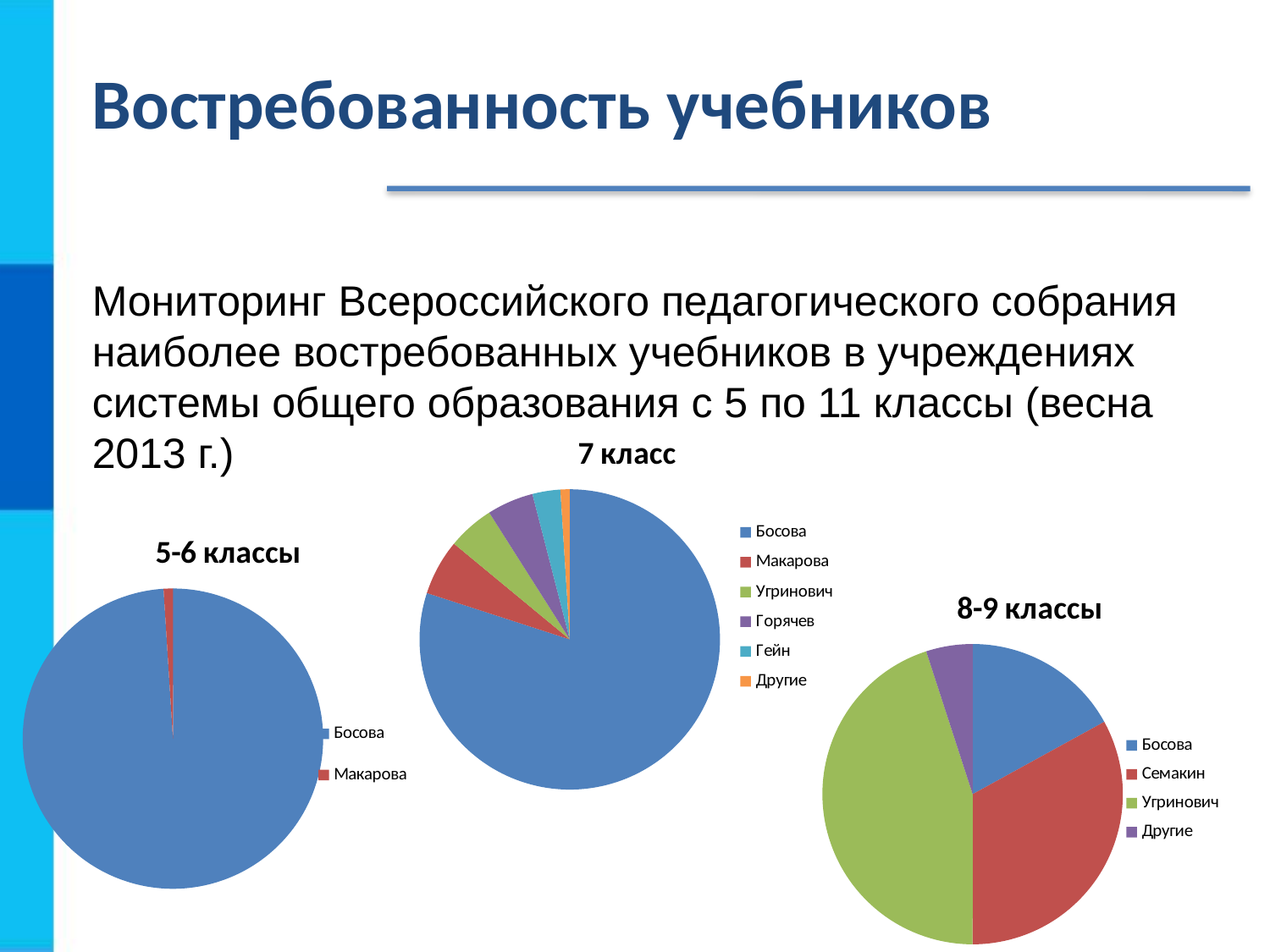
In the "7 класс" chart, which category has the largest slice? Босова In the "8-9 классы" chart, which category has the largest slice? Угринович In the "5-6 классы" chart, which category has the largest slice? Босова In the "5-6 классы" chart, which category has the smallest slice? Макарова In the "8-9 классы" chart, which category has the smallest slice? Другие In the "8-9 классы" chart, which slice is larger: Семакин or Босова? Семакин How many categories does the "8-9 классы" chart show? 4 What kind of chart is the "5-6 классы" chart? pie chart In the "7 класс" chart, which slice is larger: Макарова or Горячев? Макарова How many categories does the "5-6 классы" chart show? 2 How many categories does the "7 класс" chart show? 6 What is the title of the pie chart in the middle of the slide? 7 класс